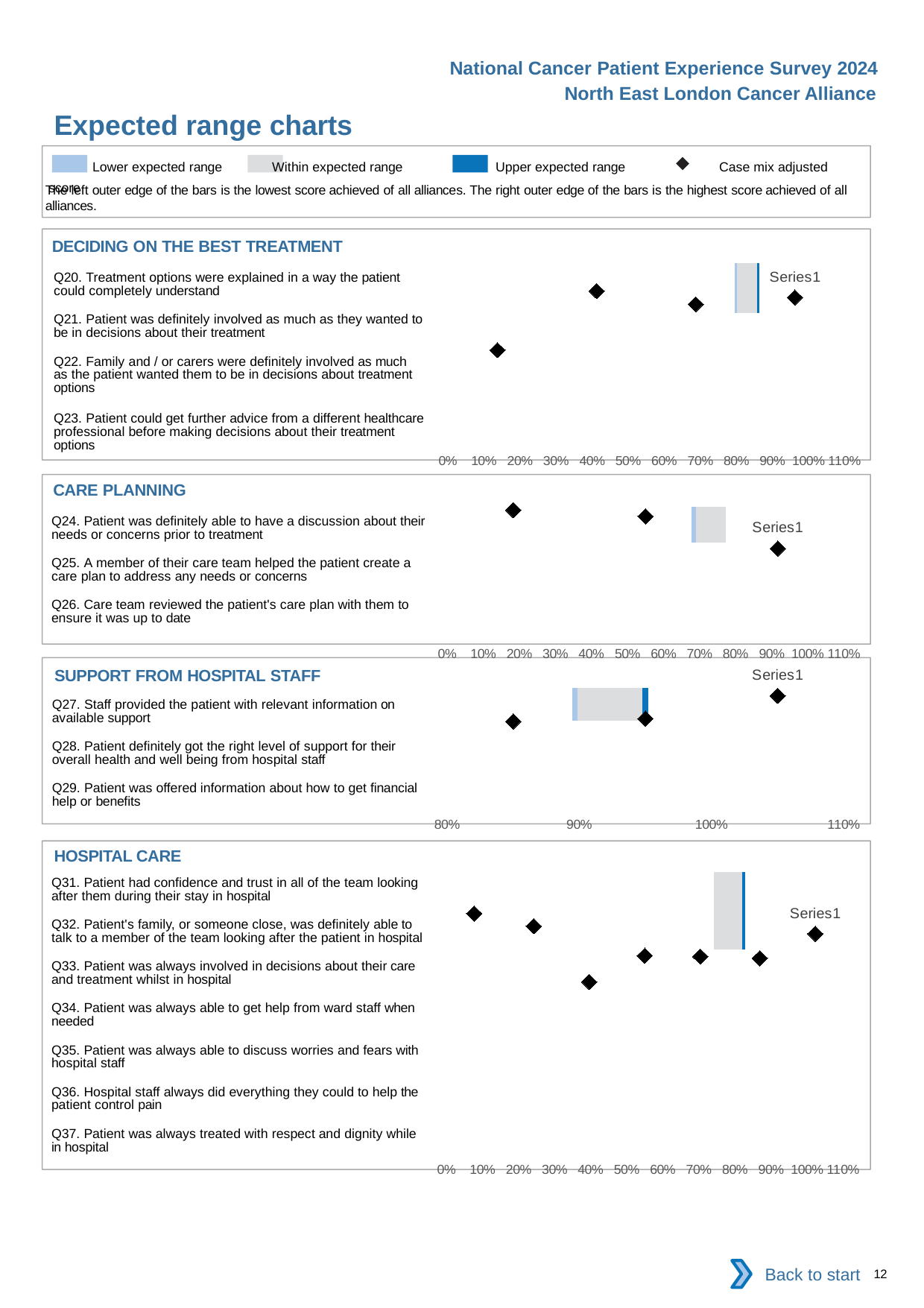
How many survey questions are listed in the DECIDING ON THE BEST TREATMENT chart? 4 How many survey questions are listed in the HOSPITAL CARE chart? 7 In the CARE PLANNING chart, is the shaded expected range bar positioned at values greater or less than 60%? greater How many entries does the legend at the top of the slide list? 4 According to the legend, what does the diamond marker represent? Case mix adjusted score In the SUPPORT FROM HOSPITAL STAFF chart, is the shaded expected range bar positioned at values greater or less than 80%? greater How many survey questions are listed in the CARE PLANNING chart? 3 What is the lowest value shown on the x axis of the SUPPORT FROM HOSPITAL STAFF chart? 80% In the HOSPITAL CARE chart, is the shaded expected range bar positioned at values greater or less than 50%? greater